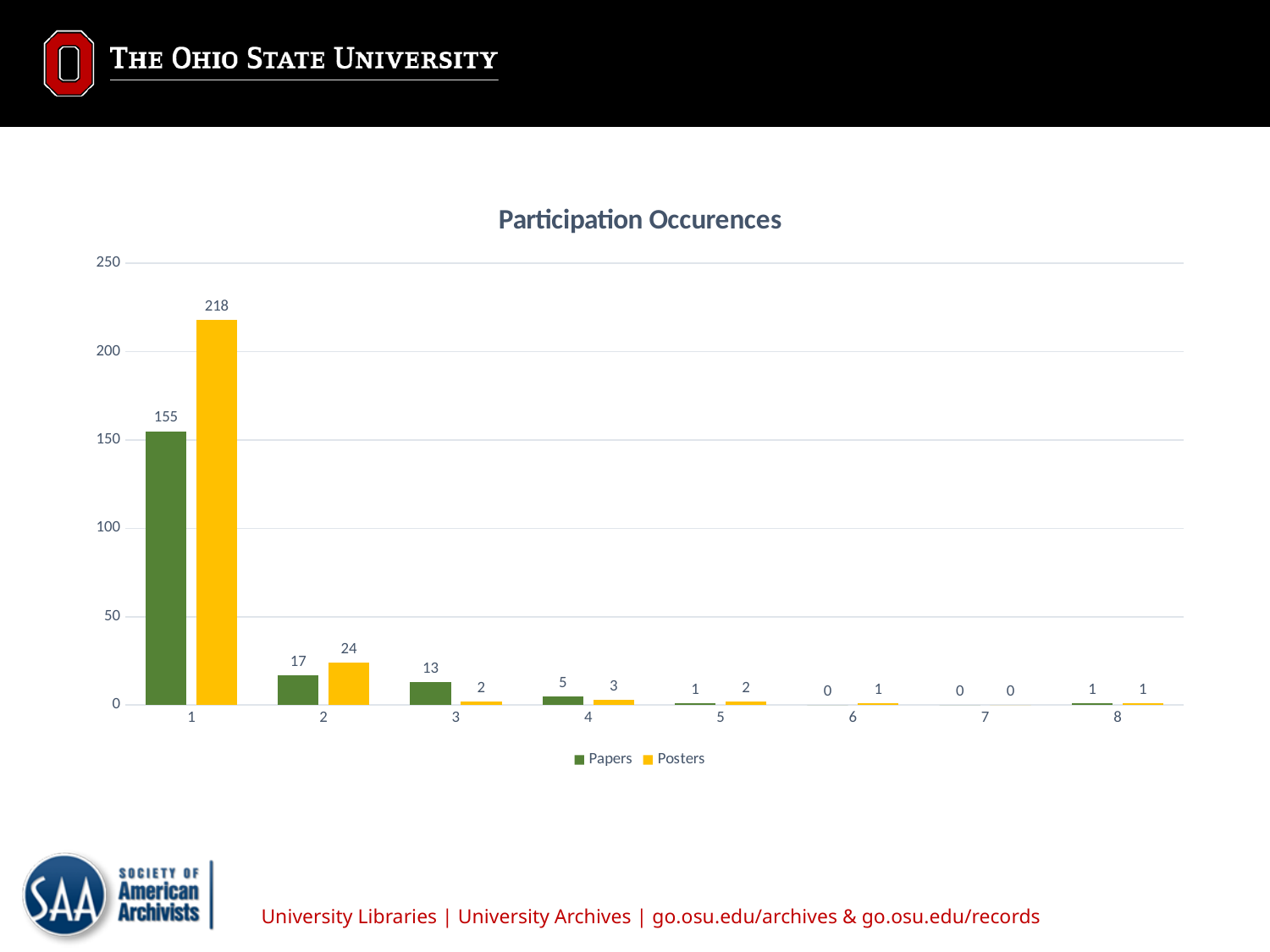
What is the value for Papers at category 3? 13 What is the value for Posters at category 1? 218 Is the value for Posters at category 1 greater or less than 200? greater What is the difference between Posters and Papers at category 1? 63 What is the title of the chart? Participation Occurences Which category has the highest value for Papers? 1 Do the Posters values generally rise or fall from category 1 to category 8? fall How many categories are shown on the x axis? 8 Which is larger at category 4, Papers or Posters? Papers What is the value for Papers at category 2? 17 What kind of chart is this? bar chart How many series does the legend list? 2